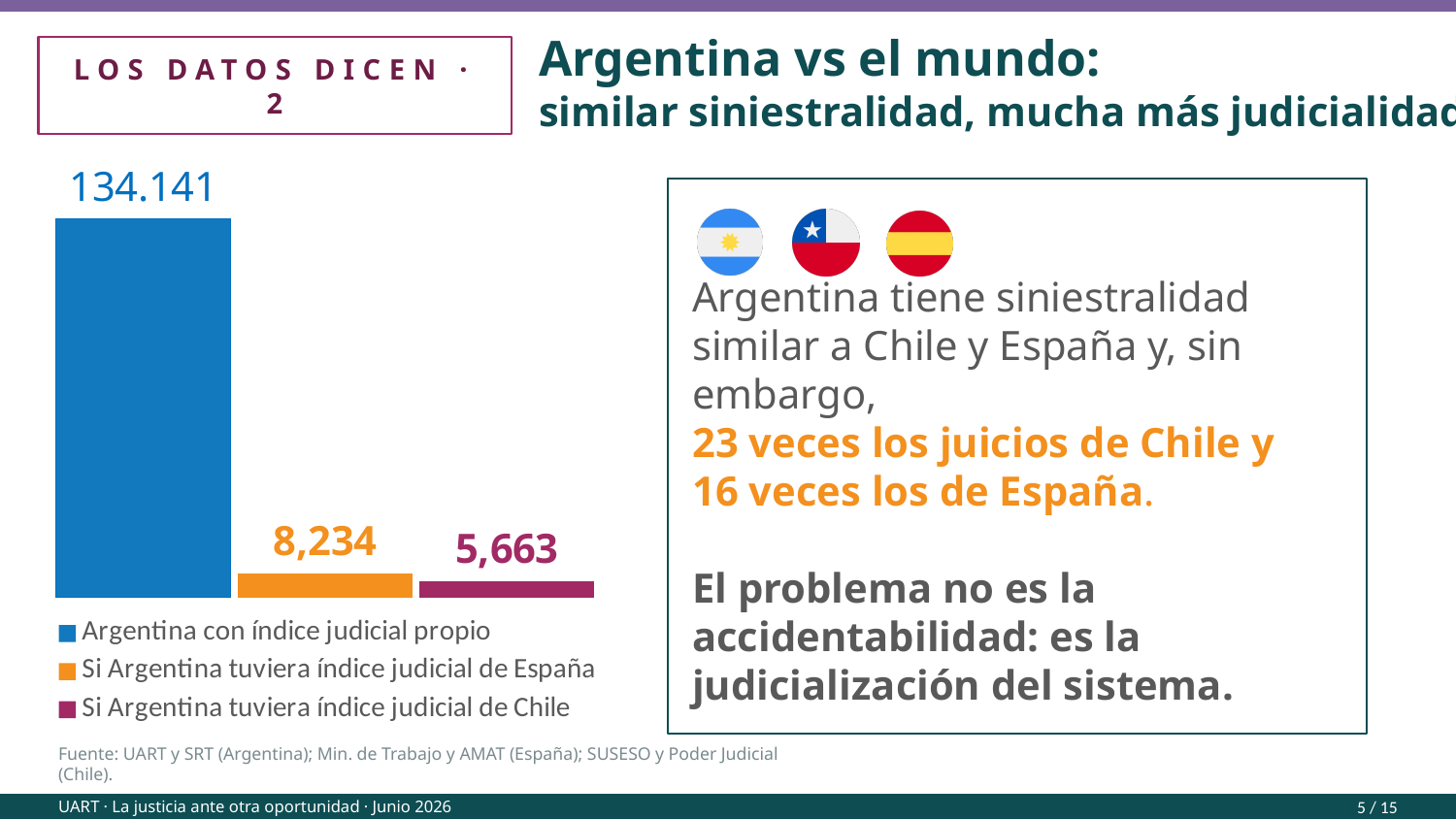
What colour is the bar for 'Argentina con índice judicial propio'? blue What value is shown for 'Si Argentina tuviera índice judicial de Chile'? 5,663 How many bars are plotted in the chart? 3 What is the difference between the value for 'Si Argentina tuviera índice judicial de España' and the value for 'Si Argentina tuviera índice judicial de Chile'? 2,571 How many series does the legend list? 3 Which is larger: the value for 'Si Argentina tuviera índice judicial de España' or for 'Si Argentina tuviera índice judicial de Chile'? Si Argentina tuviera índice judicial de España What value is shown for 'Si Argentina tuviera índice judicial de España'? 8,234 Which series has the highest value in the chart? Argentina con índice judicial propio What value is shown for 'Argentina con índice judicial propio'? 134.141 Which series has the lowest value in the chart? Si Argentina tuviera índice judicial de Chile Which series is shown in orange in the legend? Si Argentina tuviera índice judicial de España What kind of chart is shown on the slide? bar chart